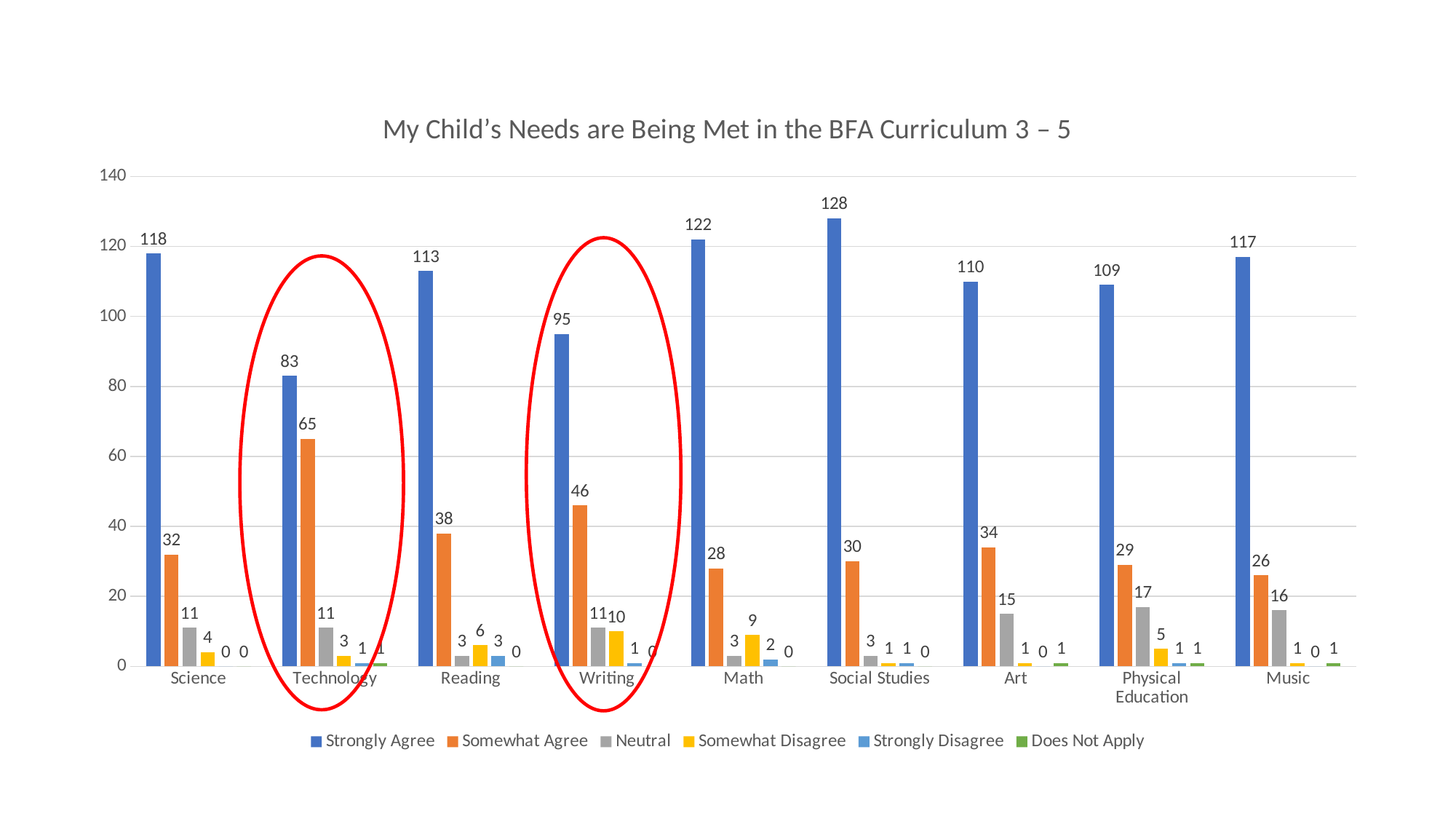
Which subject has the highest Strongly Agree value? Social Studies How many subjects are shown on the x axis? 9 What is the Strongly Agree value for Social Studies? 128 What is the Neutral value for Physical Education? 17 Which has the larger Somewhat Agree value, Reading or Writing? Writing How many series does the legend list? 6 Which two subjects are circled in red on the chart? Technology and Writing Which subject has the lowest Strongly Agree value? Technology Which subject has the highest Somewhat Agree value? Technology What is the difference between the Strongly Agree values for Science and Technology? 35 What is the Somewhat Agree value for Technology? 65 What kind of chart is shown on the slide? Bar chart